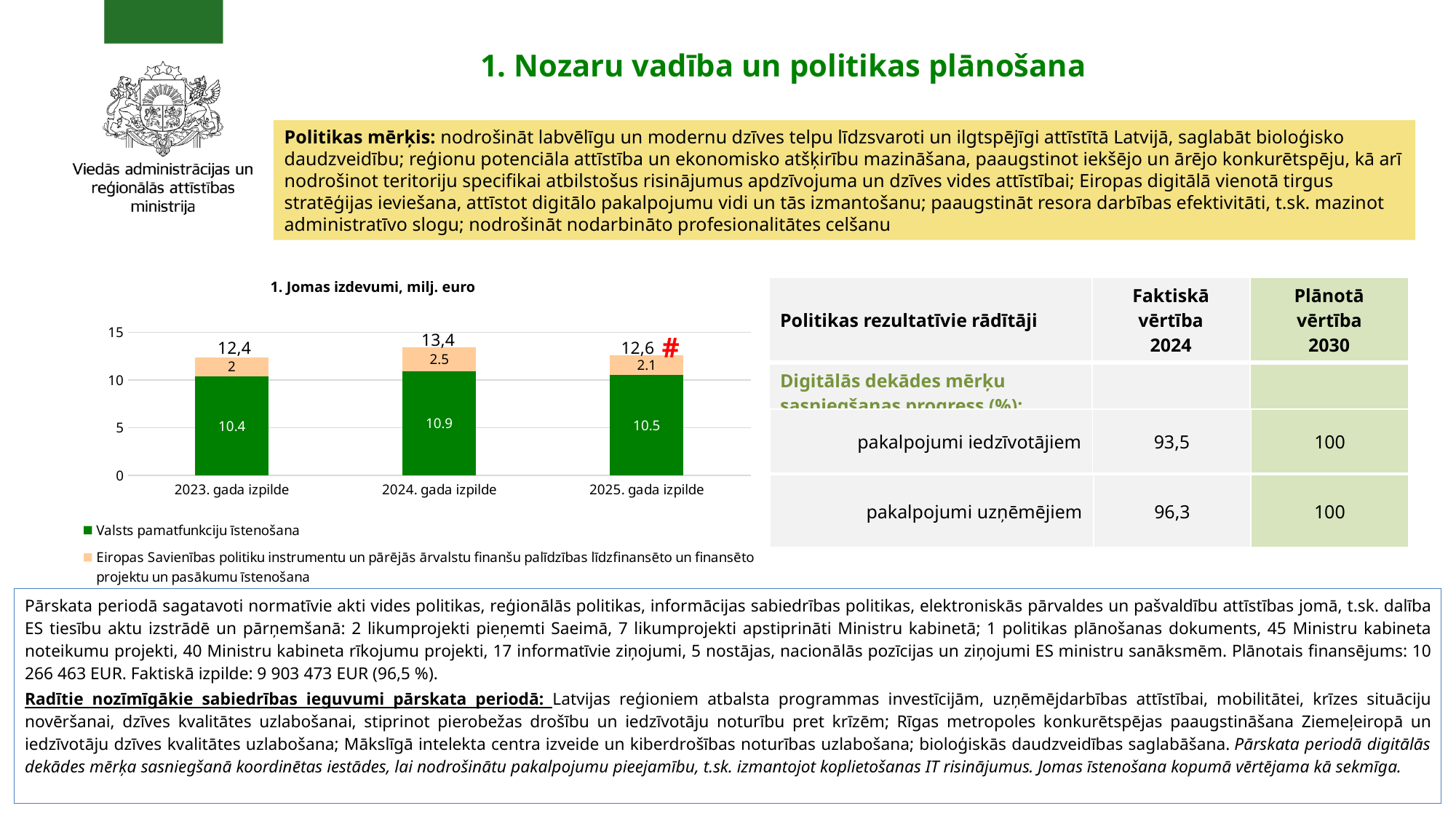
Which category has the highest total value? 2024. gada izpilde What kind of chart is shown on the slide? stacked bar chart Is the total value for 2024. gada izpilde greater or less than 10? greater What is the difference between the Valsts pamatfunkciju īstenošana values for 2024. gada izpilde and 2023. gada izpilde? 0.5 How many categories are shown on the x axis of the chart? 3 What is the total of the stacked bar for 2025. gada izpilde? 12,6 Which category has the lowest value for Valsts pamatfunkciju īstenošana? 2023. gada izpilde Which is larger: the Eiropas Savienības politiku instrumentu value for 2024. gada izpilde or for 2025. gada izpilde? 2024. gada izpilde How many series does the chart legend list? 2 What is the value of the Eiropas Savienības politiku instrumentu series for 2023. gada izpilde? 2 What is the title of the chart on the slide? 1. Jomas izdevumi, milj. euro What is the value of Valsts pamatfunkciju īstenošana for 2024. gada izpilde? 10.9